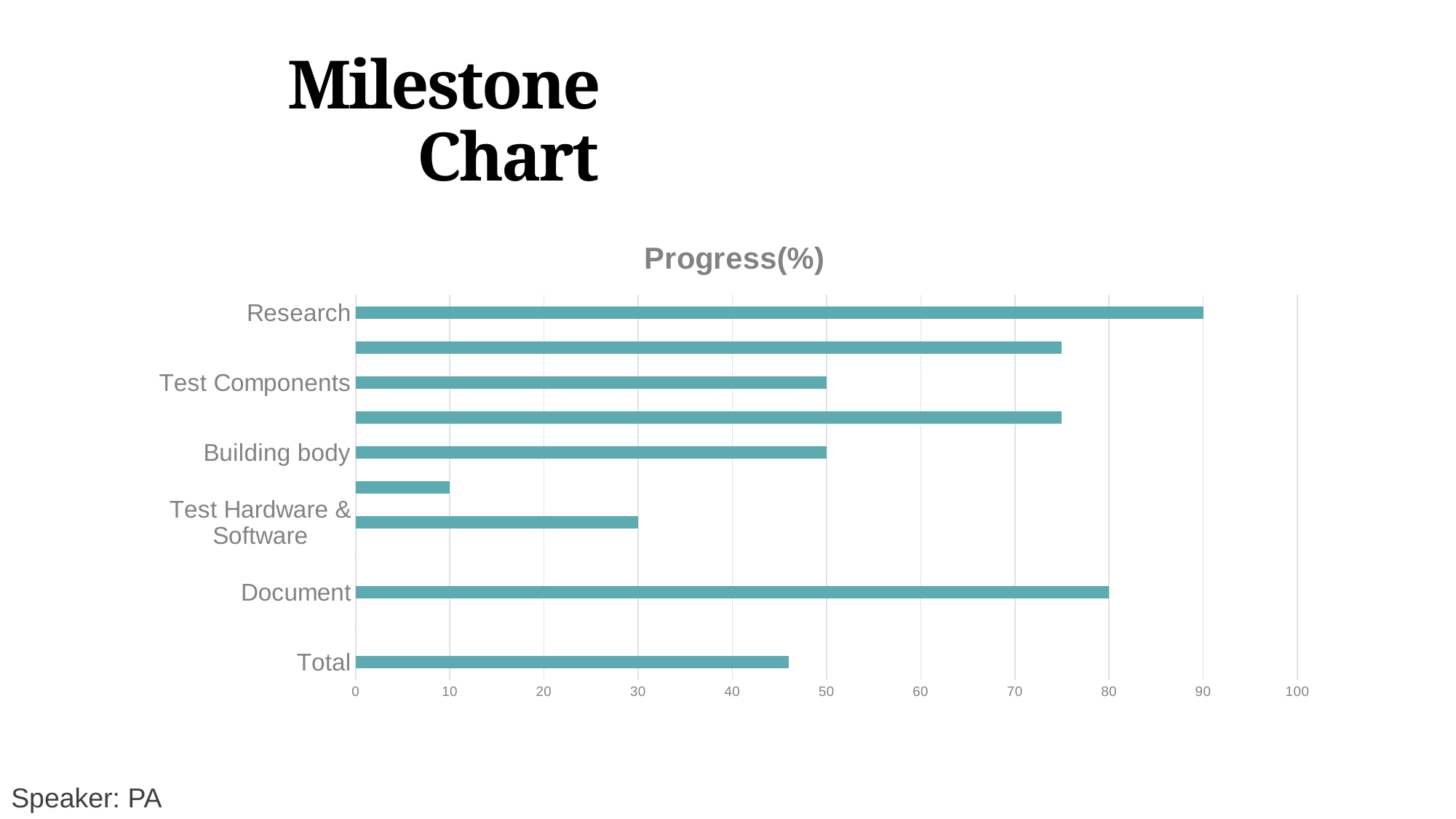
Among the labeled categories, which has the lowest value? Test Hardware & Software What kind of chart is shown on the slide? bar chart What is the difference between the values for Document and Test Hardware & Software? 50 Is the value for Total greater or less than 40? greater What is the value for Building body? 50 Which category has the highest value? Research Which is larger, the value for Document or the value for Building body? Document What is the value for Test Hardware & Software? 30 What is the title of the chart? Progress(%) What is the value for Document? 80 What is the value for Research? 90 What is the difference between the values for Research and Document? 10